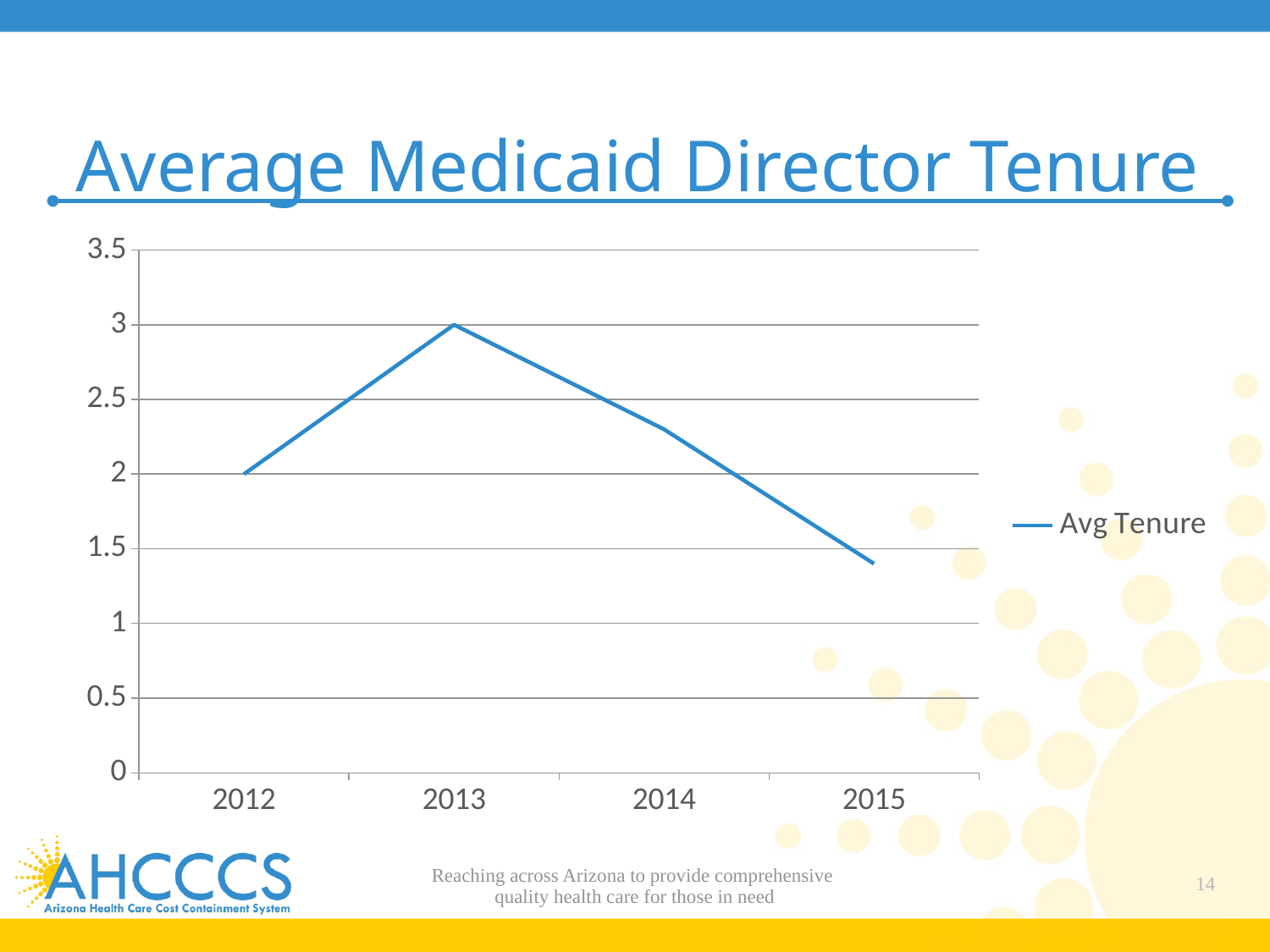
Is the Avg Tenure value for 2015 greater or less than 1.5? less What is the Avg Tenure value for 2013? 3 Which year has the lowest Avg Tenure? 2015 Does the Avg Tenure rise or fall from 2013 to 2015? Fall What is the difference between the Avg Tenure in 2013 and in 2012? 1 How many series does the legend list? 1 What is the Avg Tenure value for 2012? 2 What series name does the legend show? Avg Tenure How many years are plotted on the x axis? 4 What is the title of the chart? Average Medicaid Director Tenure What type of chart is shown on the slide? Line chart Which year has the highest Avg Tenure? 2013